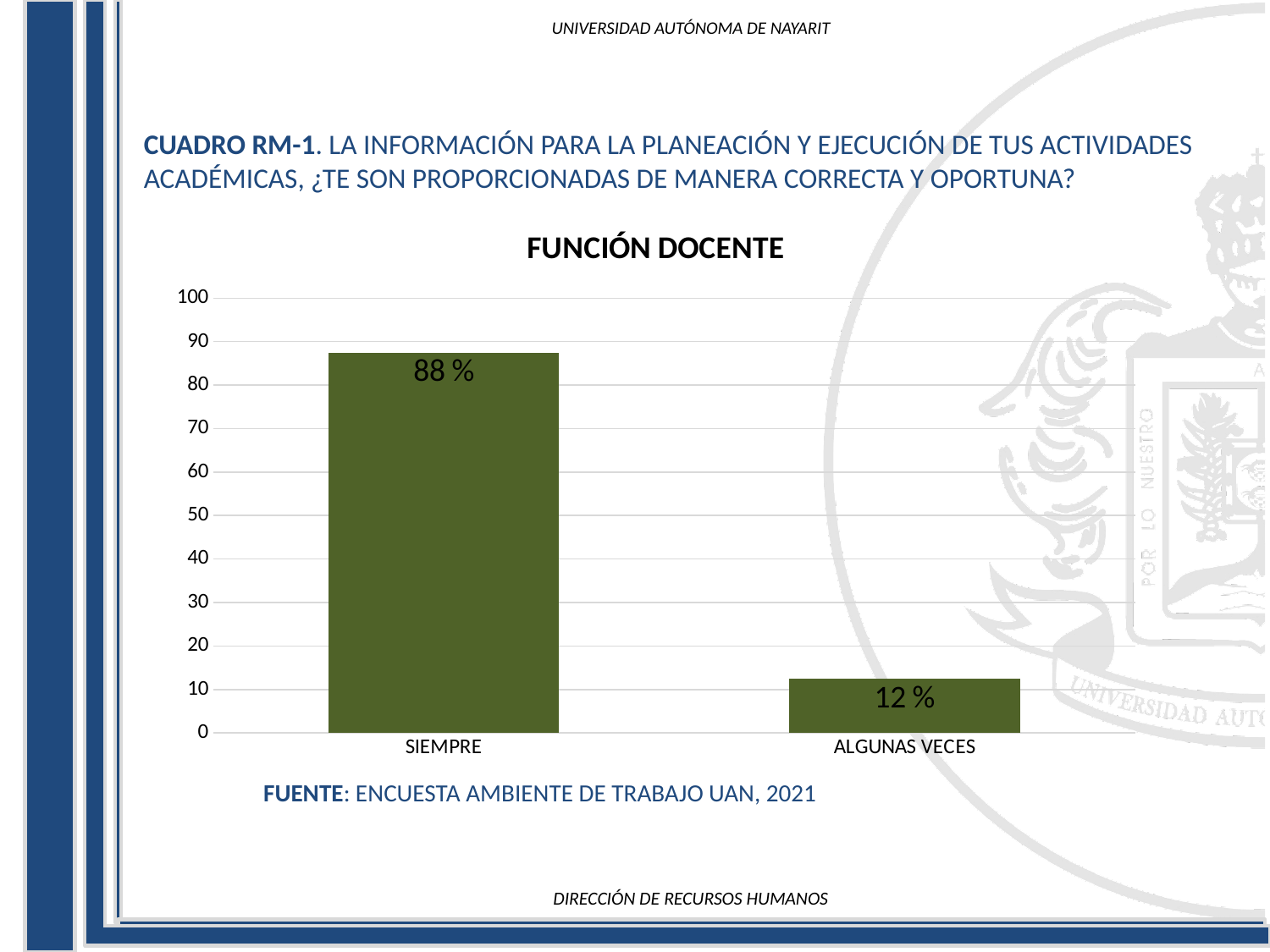
What is the highest value shown on the vertical axis? 100 What is the difference between the values for SIEMPRE and ALGUNAS VECES? 76 % Which category has the lowest value? ALGUNAS VECES What is the title of the chart? FUNCIÓN DOCENTE What is the value for SIEMPRE? 88 % What kind of chart is shown on the slide? bar chart Is the value for ALGUNAS VECES greater or less than 20? less Which category has the highest value? SIEMPRE What is the value for ALGUNAS VECES? 12 % Which is larger, the value for SIEMPRE or the value for ALGUNAS VECES? SIEMPRE Is the value for SIEMPRE greater or less than 50? greater How many categories are shown in the chart? 2